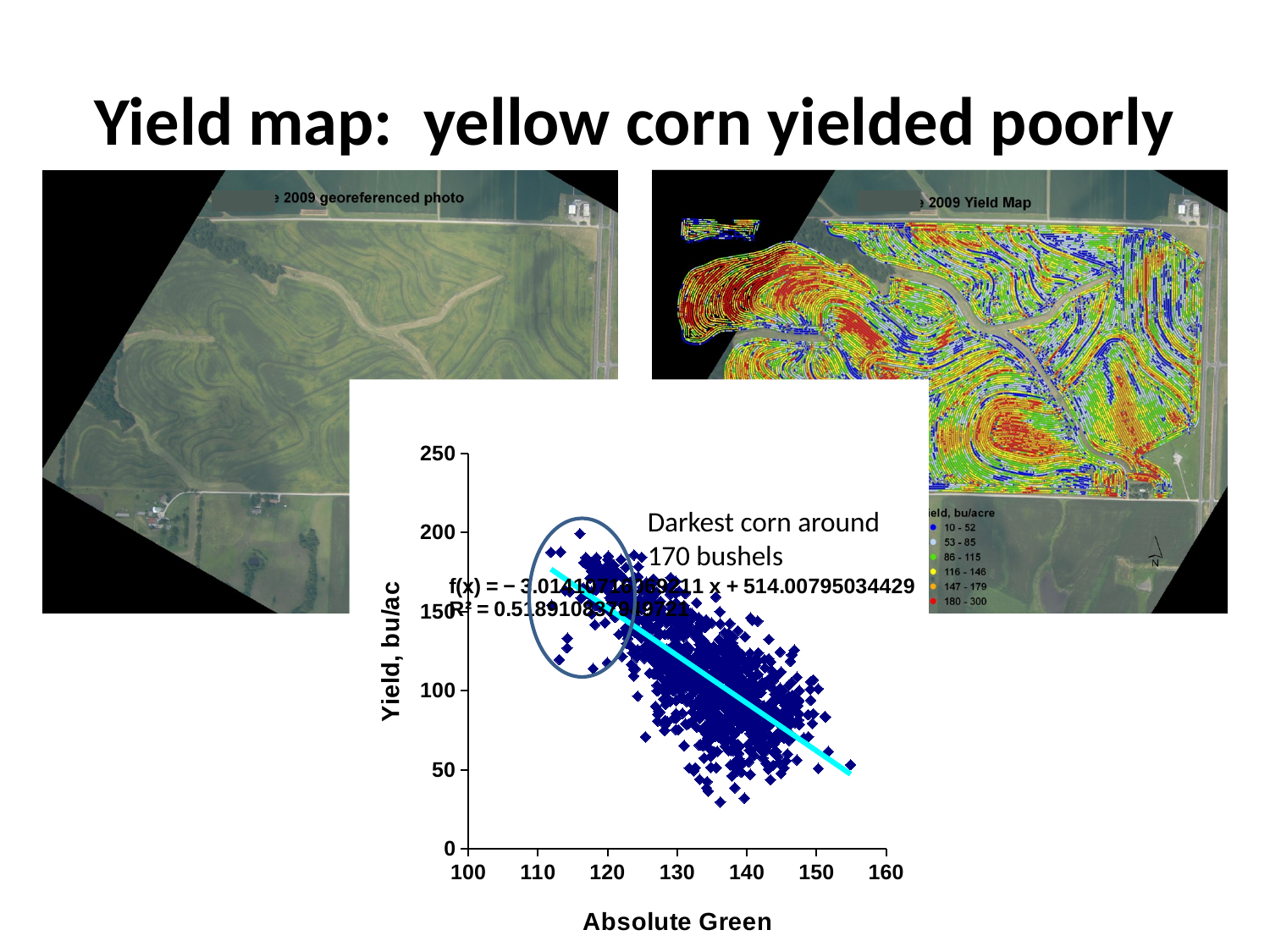
Is the slope of the trendline on the scatter chart positive or negative? negative What is the title of the x axis of the scatter chart? Absolute Green What is the title of the y axis of the scatter chart? Yield, bu/ac What is the minimum value shown on the x axis of the scatter chart? 100 According to the annotation on the scatter chart, around how many bushels did the darkest corn yield? 170 bushels Is the trendline's yield value at Absolute Green 150 greater or less than 100? less Does yield rise or fall as Absolute Green increases along the x axis? fall What is the maximum value shown on the x axis of the scatter chart? 160 Is the trendline's yield value at Absolute Green 115 greater or less than 150? greater What kind of chart is shown on the slide? scatter chart What is the maximum value shown on the y axis of the scatter chart? 250 What is the intercept (constant term) in the trendline equation shown on the scatter chart? 514.00795034429